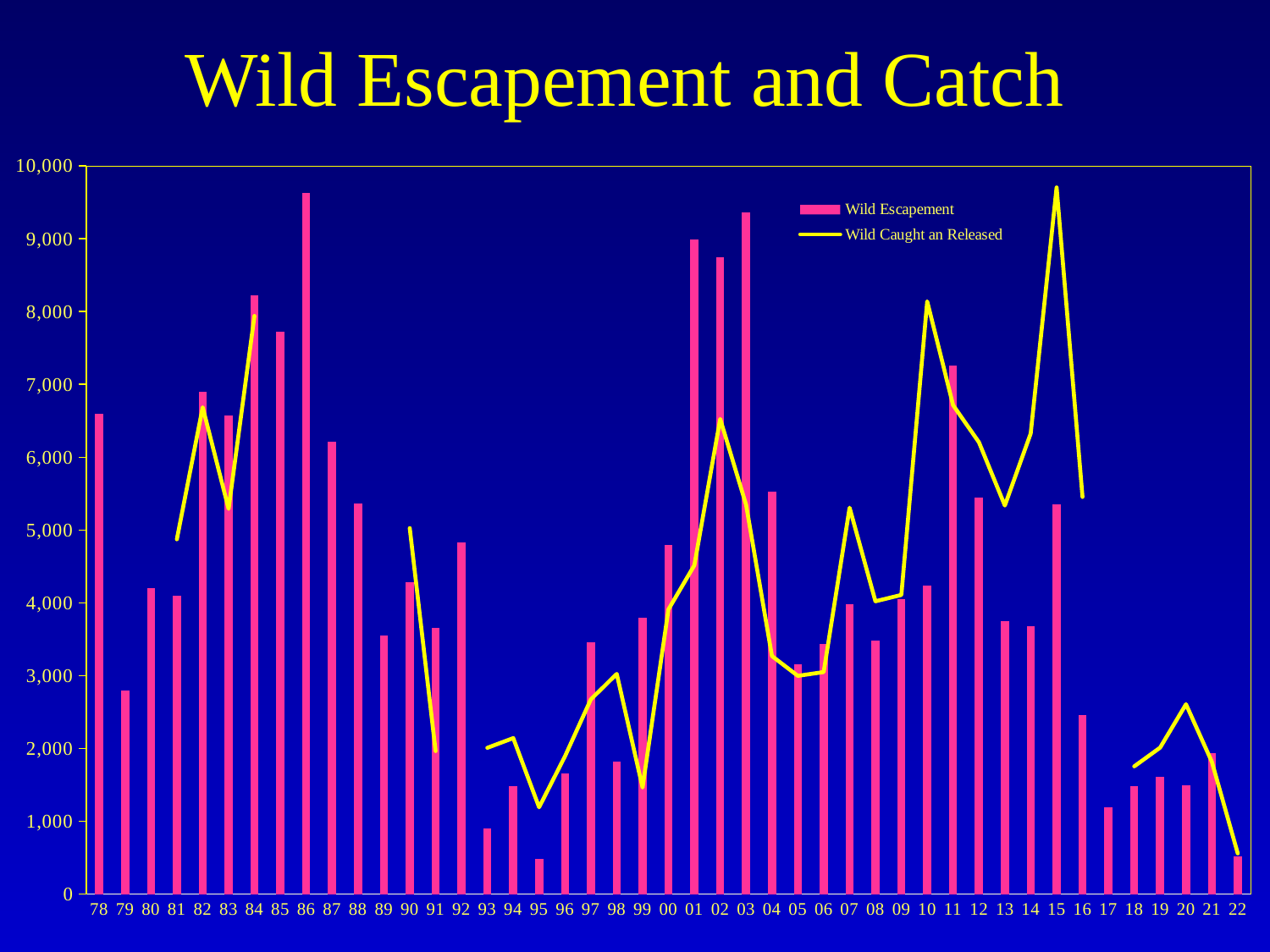
How many series does the legend list? 2 What are the two series named in the legend? Wild Escapement and Wild Caught an Released Which year has the lowest Wild Escapement bar? 95 Which year has the highest Wild Escapement bar? 86 In which year does the Wild Caught an Released line reach its highest point? 15 Is the Wild Escapement value for 95 greater or less than 1,000? less What type of chart is shown on the slide? A bar chart combined with a line chart Do the Wild Escapement bars rise or fall from 86 to 89? fall Which year has the larger Wild Escapement bar, 78 or 79? 78 How many years are shown along the x axis? 45 Is the Wild Escapement value for 86 greater or less than 9,000? greater Is the Wild Caught an Released value for 22 greater or less than 1,000? less